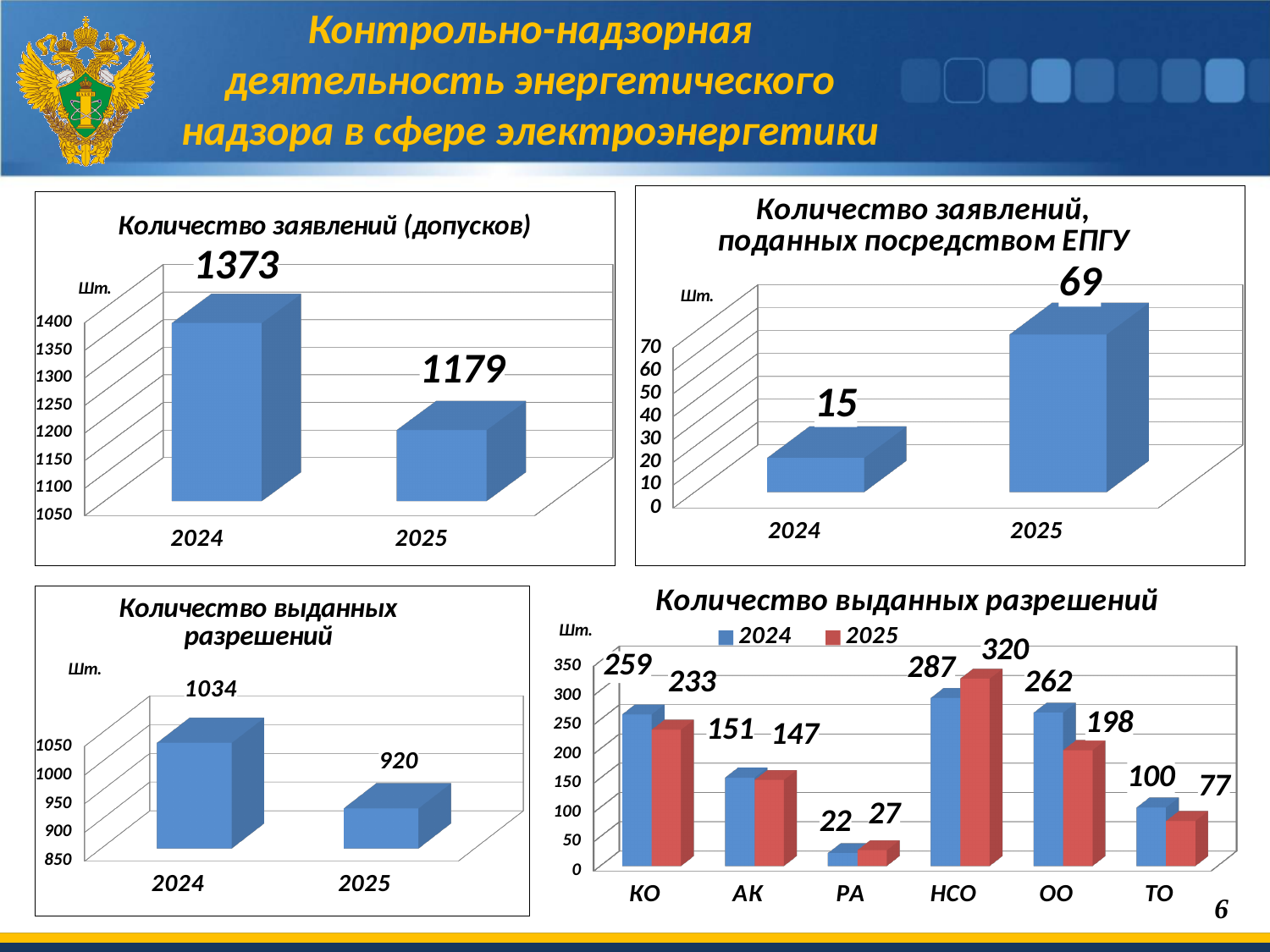
In the chart titled 'Количество заявлений, поданных посредством ЕПГУ', what is the value for 2025? 69 In the chart titled 'Количество заявлений, поданных посредством ЕПГУ', do the values rise or fall from 2024 to 2025? rise In the bottom-left chart titled 'Количество выданных разрешений', which year has the higher value? 2024 In the bottom-right chart 'Количество выданных разрешений' by region, how many regions are shown on the x axis? 6 In the chart titled 'Количество заявлений (допусков)', what is the difference between the 2024 and 2025 values? 194 In the chart titled 'Количество заявлений (допусков)', what is the value for 2024? 1373 In the bottom-left chart titled 'Количество выданных разрешений', what is the value for 2025? 920 In the bottom-right chart 'Количество выданных разрешений' by region, how many series does the legend list? 2 In the bottom-right chart 'Количество выданных разрешений' by region, what is the difference between the 2024 and 2025 values for ОО? 64 In the bottom-right chart 'Количество выданных разрешений' by region, what is the 2025 value for НСО? 320 What kind of chart is the bottom-right chart 'Количество выданных разрешений' by region? bar chart In the bottom-right chart 'Количество выданных разрешений' by region, which region has the lowest 2024 value? РА